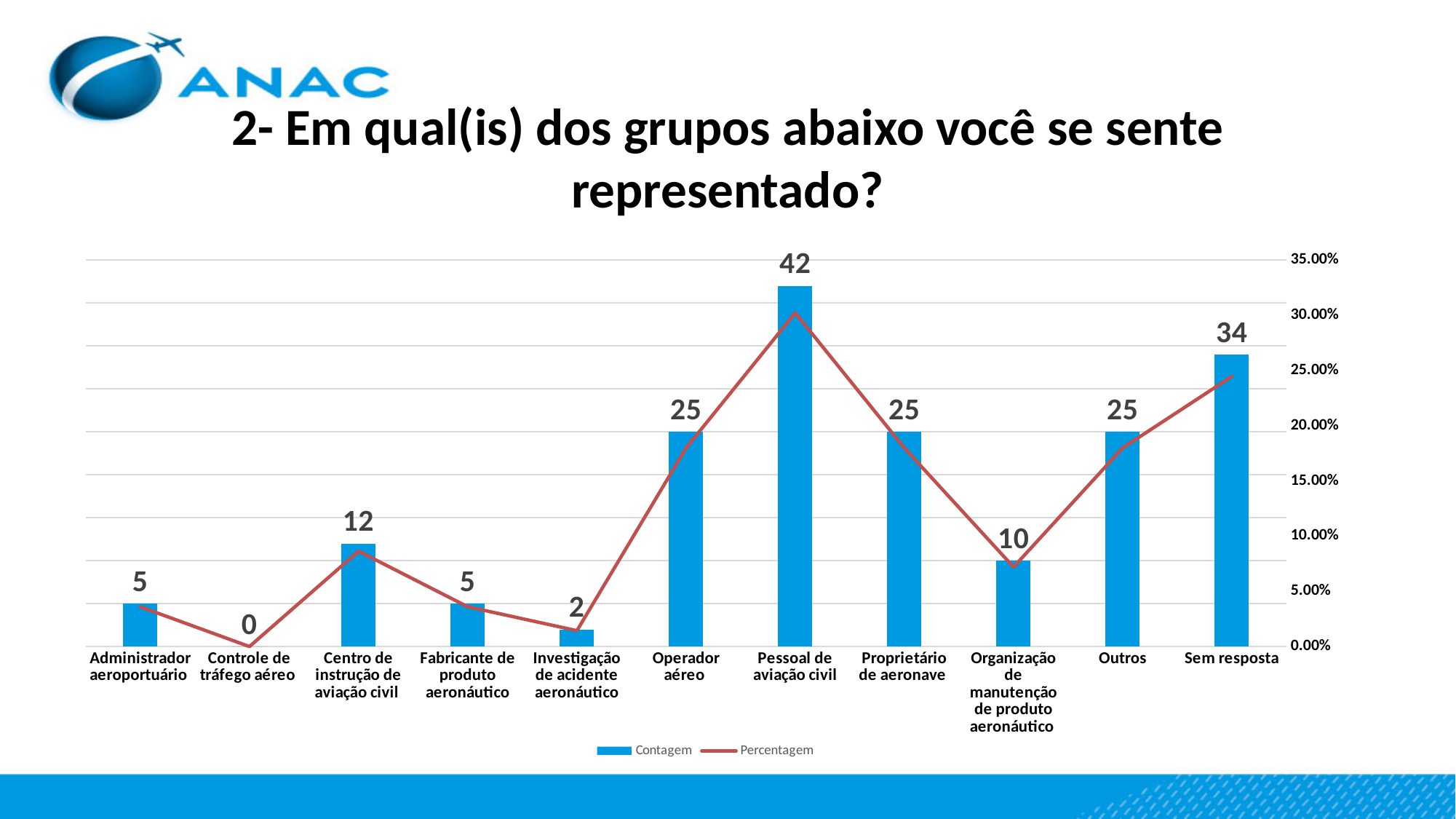
Is the Percentagem value for Organização de manutenção de produto aeronáutico greater or less than 10.00%? less What is the difference between the Contagem values for Pessoal de aviação civil and Sem resposta? 8 What is the Contagem value for Centro de instrução de aviação civil? 12 Which category has the highest Contagem value? Pessoal de aviação civil What is the Contagem value for Sem resposta? 34 Which category has the lowest Contagem value? Controle de tráfego aéreo What is the Contagem value for Pessoal de aviação civil? 42 How many series does the legend list? 2 How many categories are shown on the x axis? 11 Is the Percentagem value for Sem resposta greater or less than 20.00%? greater What kind of chart is shown on the slide? A bar chart with a line Which has a larger Contagem value, Organização de manutenção de produto aeronáutico or Centro de instrução de aviação civil? Centro de instrução de aviação civil